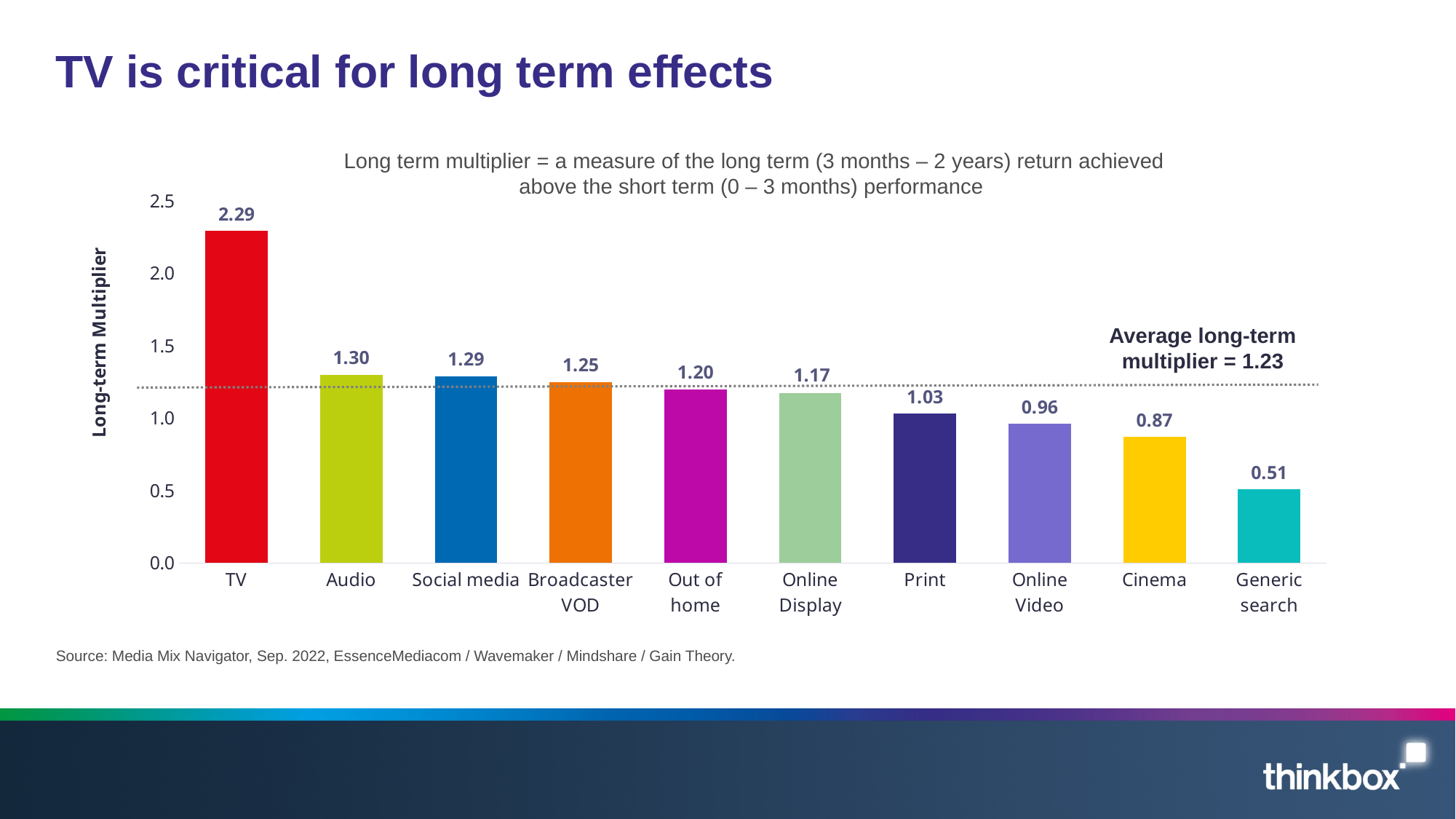
Is the value for Online Display greater or less than 1.0? greater Which has a higher long-term multiplier, Print or Online Video? Print What is the average long-term multiplier indicated by the dotted line? 1.23 What is the long-term multiplier for Broadcaster VOD? 1.25 How many categories are shown in the chart? 10 What kind of chart is shown on the slide? Bar chart Which category has the lowest long-term multiplier? Generic search Which category has the highest long-term multiplier? TV What is the long-term multiplier for Cinema? 0.87 What is the long-term multiplier for TV? 2.29 Do the values rise or fall from left to right along the x axis? Fall What is the difference between the long-term multiplier for TV and for Audio? 0.99